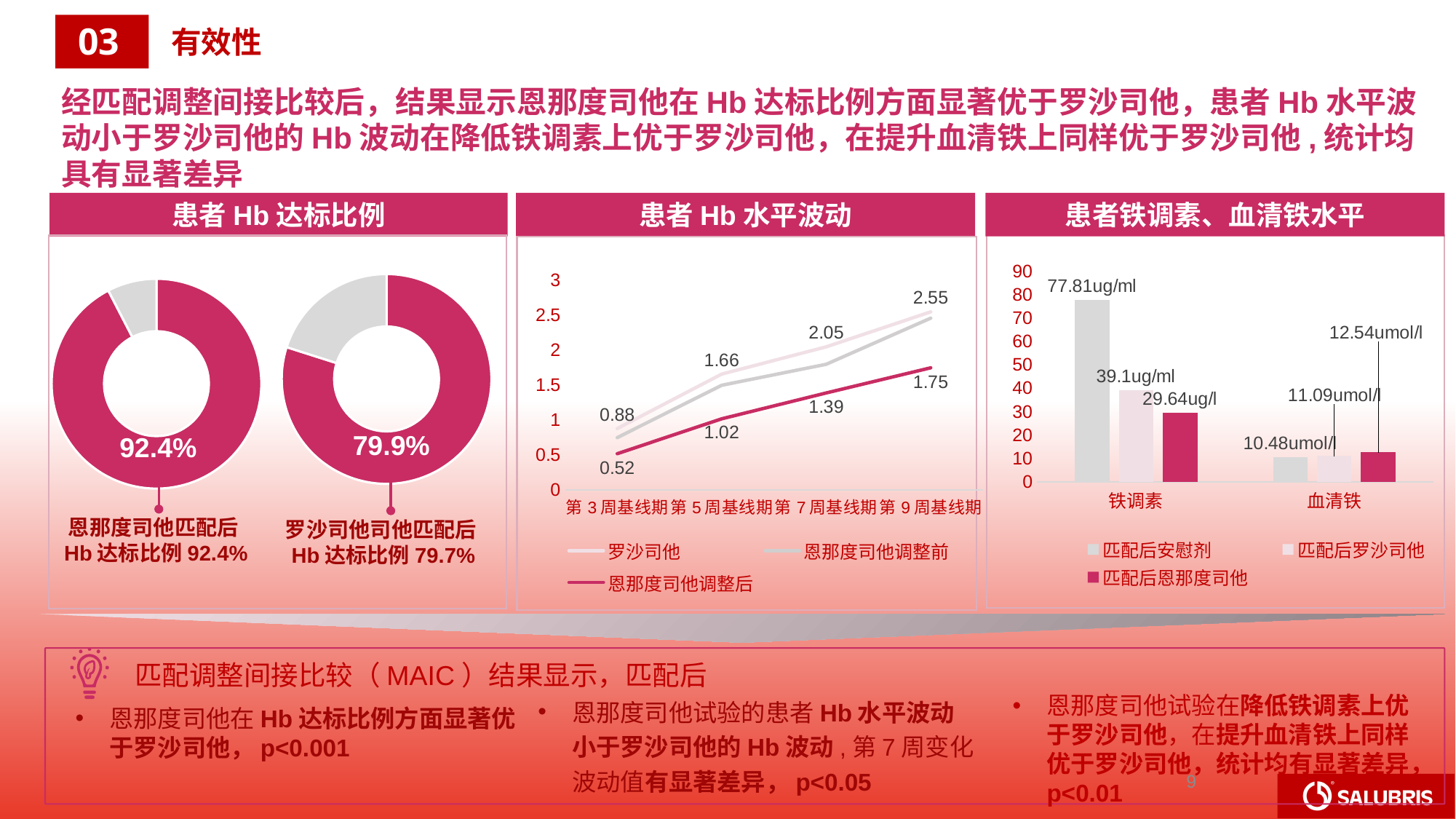
What kind of chart is the '患者铁调素、血清铁水平' chart? bar chart In the '患者 Hb 达标比例' panel, what Hb 达标比例 is shown in the 恩那度司他匹配后 donut? 92.4% In the '患者铁调素、血清铁水平' chart, how many series does the legend list? 3 In the '患者铁调素、血清铁水平' chart, for 血清铁, which is larger: 匹配后恩那度司他 or 匹配后安慰剂? 匹配后恩那度司他 In the '患者铁调素、血清铁水平' chart, which series has the highest value for 铁调素? 匹配后安慰剂 In the '患者 Hb 水平波动' chart, how many time points are shown on the x axis? 4 In the '患者 Hb 水平波动' chart, do the values of 恩那度司他调整后 rise or fall from 第 3 周基线期 to 第 9 周基线期? rise In the '患者铁调素、血清铁水平' chart, what is the difference between 匹配后安慰剂 and 匹配后罗沙司他 for 铁调素? 38.71ug/ml In the '患者 Hb 水平波动' chart, what is the value of 恩那度司他调整后 at 第 9 周基线期? 1.75 In the '患者铁调素、血清铁水平' chart, what is the value of 匹配后恩那度司他 for 血清铁? 12.54umol/l In the '患者 Hb 水平波动' chart, how many series does the legend list? 3 In the '患者铁调素、血清铁水平' chart, what is the value of 匹配后安慰剂 for 铁调素? 77.81ug/ml